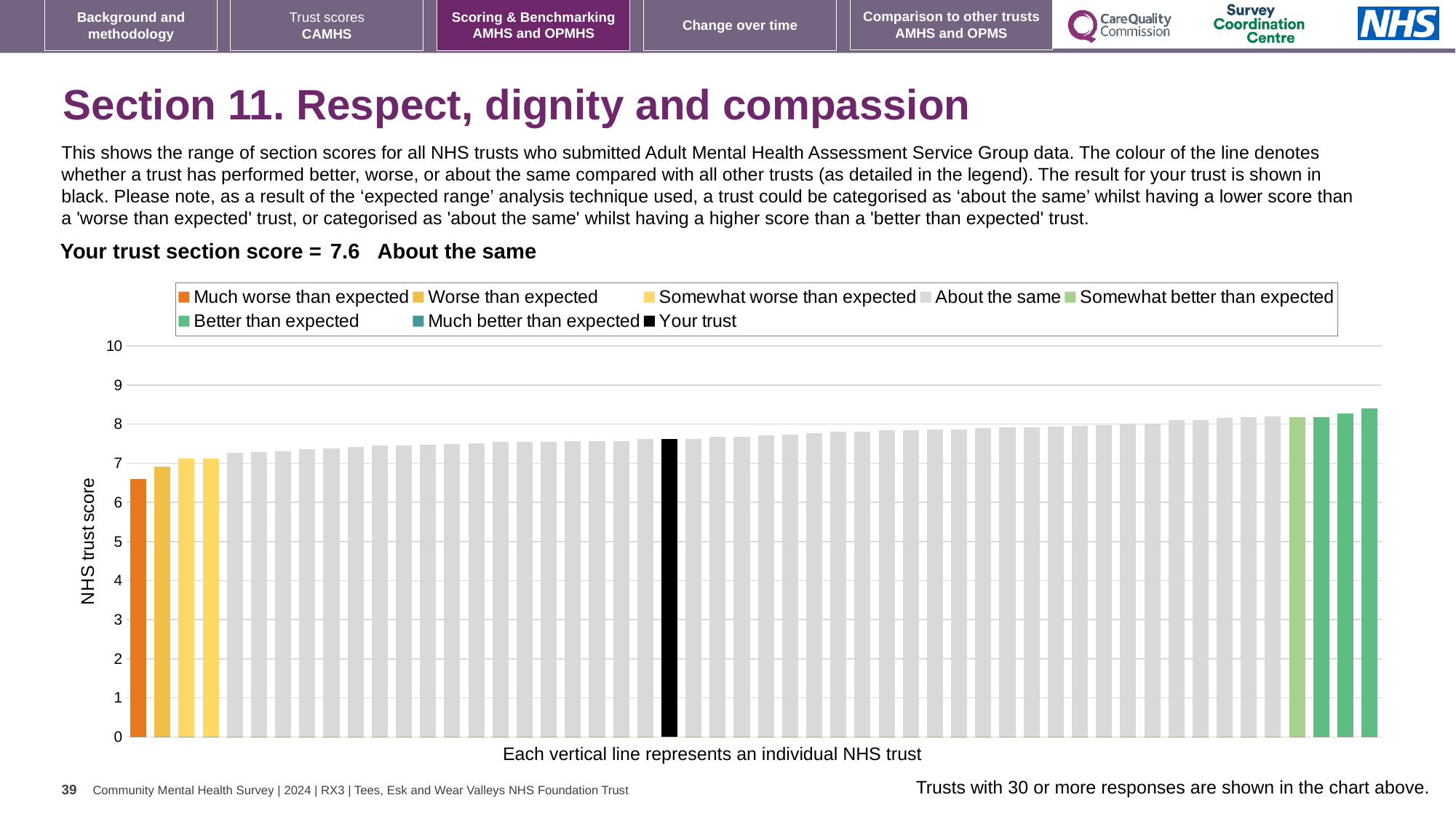
Which category is your trust's section score placed in? About the same What is the label on the vertical axis of the chart? NHS trust score How many bars are coloured orange for 'Much worse than expected'? 1 How many entries does the chart legend list? 8 What colour is the bar representing your trust? black Is the value for the orange 'Much worse than expected' bar greater or less than 7? less What is the section score for your trust shown on the slide? 7.6 Is the black 'Your trust' bar higher or lower than the orange 'Much worse than expected' bar? higher Is the value for the black 'Your trust' bar greater or less than 7? greater Do the bar values rise or fall from left to right across the chart? rise What kind of chart is shown on the slide? bar chart Is the value for the rightmost bar greater or less than 8? greater